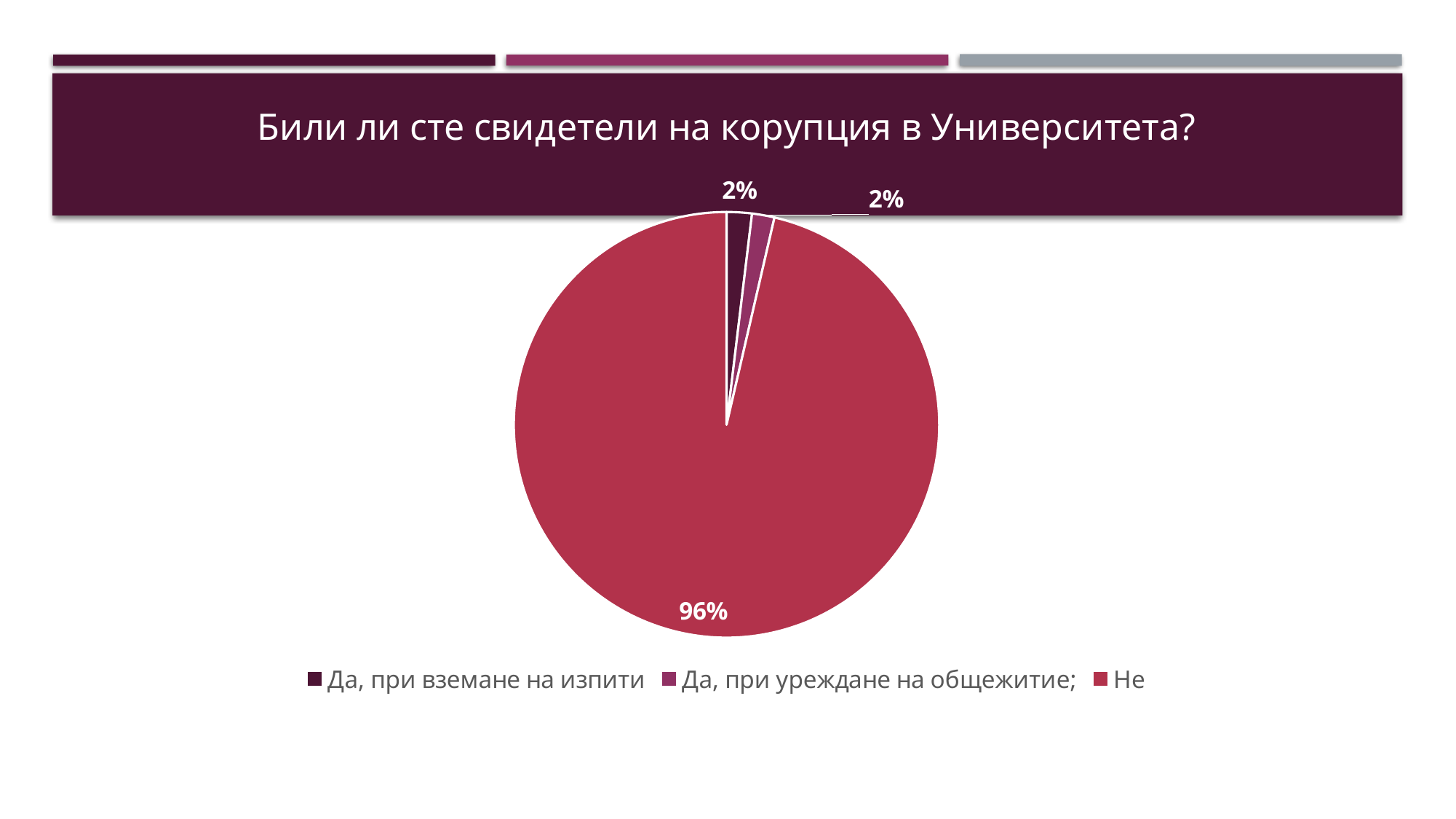
What is the combined share of the two "Да" categories? 4% Which is larger, the slice for "Не" or the slice for "Да, при уреждане на общежитие;"? Не How many entries does the legend list? 3 What is the difference between the share for "Не" and the share for "Да, при вземане на изпити"? 94% What is the value shown for "Да, при уреждане на общежитие;"? 2% What is the title of the chart? Били ли сте свидетели на корупция в Университета? How many slices does the pie chart have? 3 What kind of chart is shown on the slide? pie chart Which legend entry is shown in the darkest colour? Да, при вземане на изпити Which category has the largest slice of the pie? Не What is the value shown for "Да, при вземане на изпити"? 2% What share of the pie does "Не" take? 96%